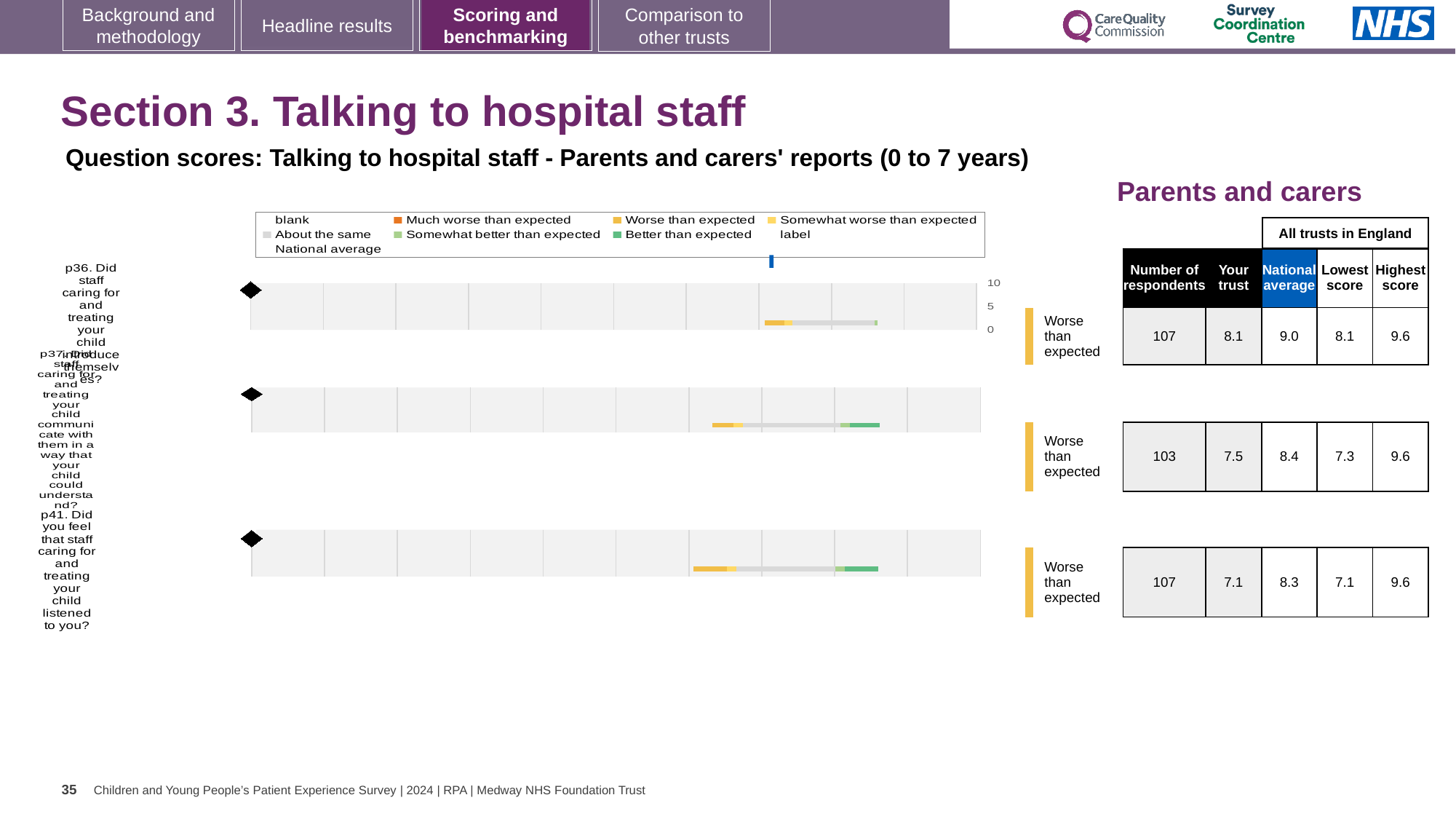
What is the difference between the national average and the 'Your trust' score for question p41? 1.2 What is the highest tick value shown on the axis of the p36 chart? 10 Which legend entry is shown in orange? Much worse than expected In the table, how many respondents are recorded for question p41? 107 Which of the three questions has the highest 'Your trust' score? p36 In the table, what is the lowest score across all trusts in England for question p41? 7.1 What kind of chart is used to show the benchmark result for question p36? bar chart In the table, what is the national average for question p37? 8.4 How many question charts are shown on the slide? 3 What benchmark category is given for question p37 (staff communicating in a way your child could understand)? Worse than expected In the table, what is the 'Your trust' score for question p36? 8.1 Which of the three questions has the lowest 'Your trust' score? p41